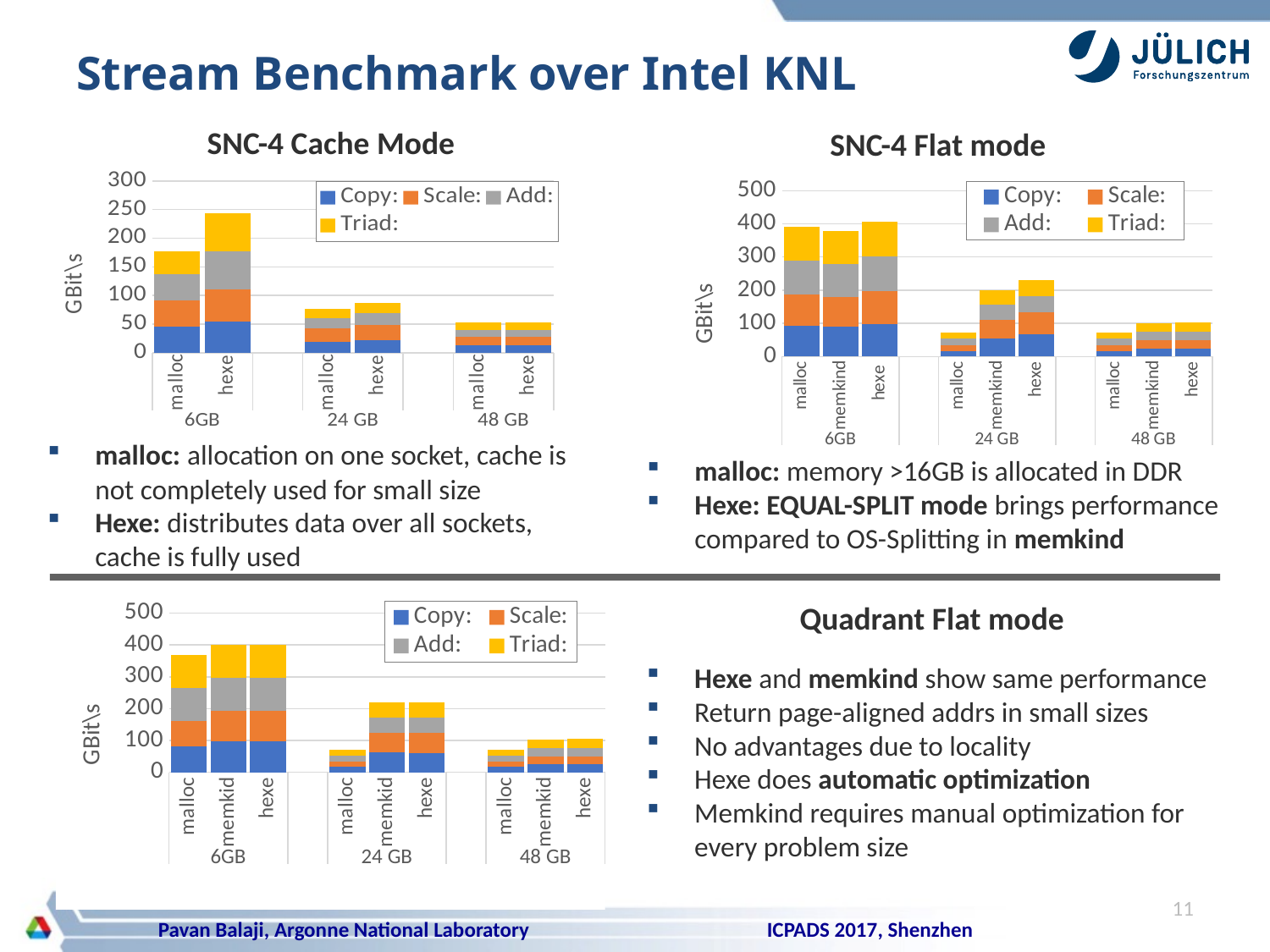
In the SNC-4 Cache Mode chart, is the total for hexe at 6GB greater or less than 200? greater How many series does the legend of the SNC-4 Cache Mode chart list? 4 In the SNC-4 Cache Mode chart, which bar is the highest? hexe at 6GB How many bars are plotted in the SNC-4 Cache Mode chart? 6 In the SNC-4 Flat mode chart, which is larger at 24 GB, malloc or hexe? hexe What kind of chart is the SNC-4 Cache Mode chart? bar chart How many bars are plotted in the SNC-4 Flat mode chart? 9 In the bottom-left chart, is the total for malloc at 24 GB greater or less than 100? less What is the y-axis label of the SNC-4 Flat mode chart? GBit\s In the SNC-4 Flat mode chart, is the total for hexe at 24 GB greater or less than 200? greater In the bottom-left chart, which is larger at 24 GB, malloc or memkind? memkind In the SNC-4 Cache Mode chart, which is larger at 6GB, malloc or hexe? hexe